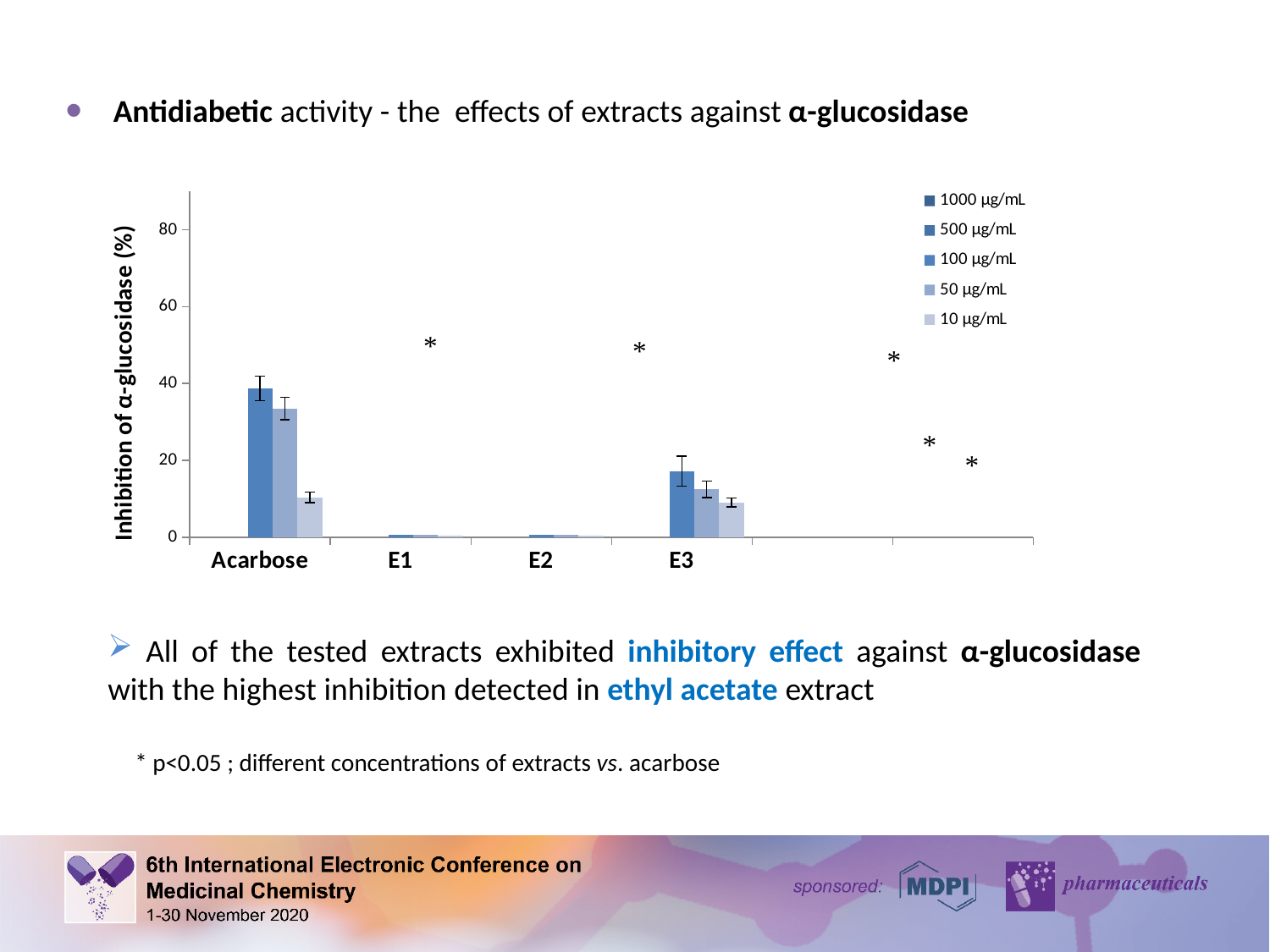
Is the tallest bar for E3 greater or less than 40? less What is the first entry in the legend? 1000 µg/mL What kind of chart is shown on the slide? bar chart Which has the higher inhibition, E3 or E1? E3 What is the title of the y axis? Inhibition of α-glucosidase (%) Is the shortest visible bar for Acarbose greater or less than 20? less Is the tallest bar for Acarbose greater or less than 20? greater Which has the higher inhibition, Acarbose or E3? Acarbose How many series does the legend list? 5 Which category shows the highest inhibition of α-glucosidase? Acarbose How many categories are labelled on the x axis? 4